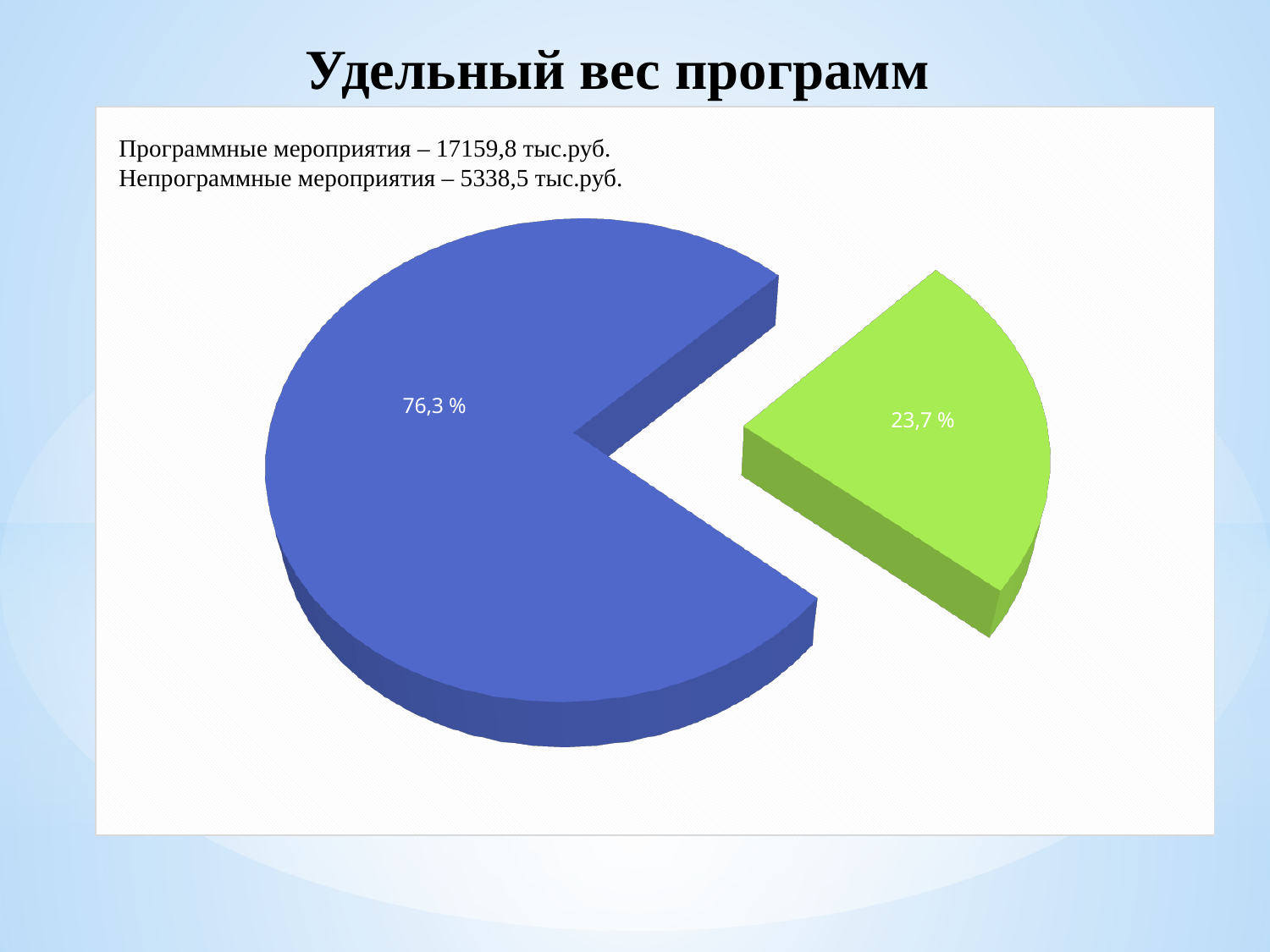
What share of the pie do Непрограммные мероприятия account for? 23,7 % What percentage is shown on the blue slice of the pie chart? 76,3 % What share of the pie do Программные мероприятия account for? 76,3 % What is the title of the slide with the pie chart? Удельный вес программ What percentage is shown on the green slice of the pie chart? 23,7 % Which slice of the pie chart is the smallest? the green slice (23,7 %) Which slice is larger, the blue one or the green one? the blue one What kind of chart is shown on the slide? pie chart What colour is the slice representing 23,7 %? green How many slices does the pie chart have? 2 Which slice of the pie chart is the largest? the blue slice (76,3 %) What is the difference in percentage points between the blue slice and the green slice? 52,6 %